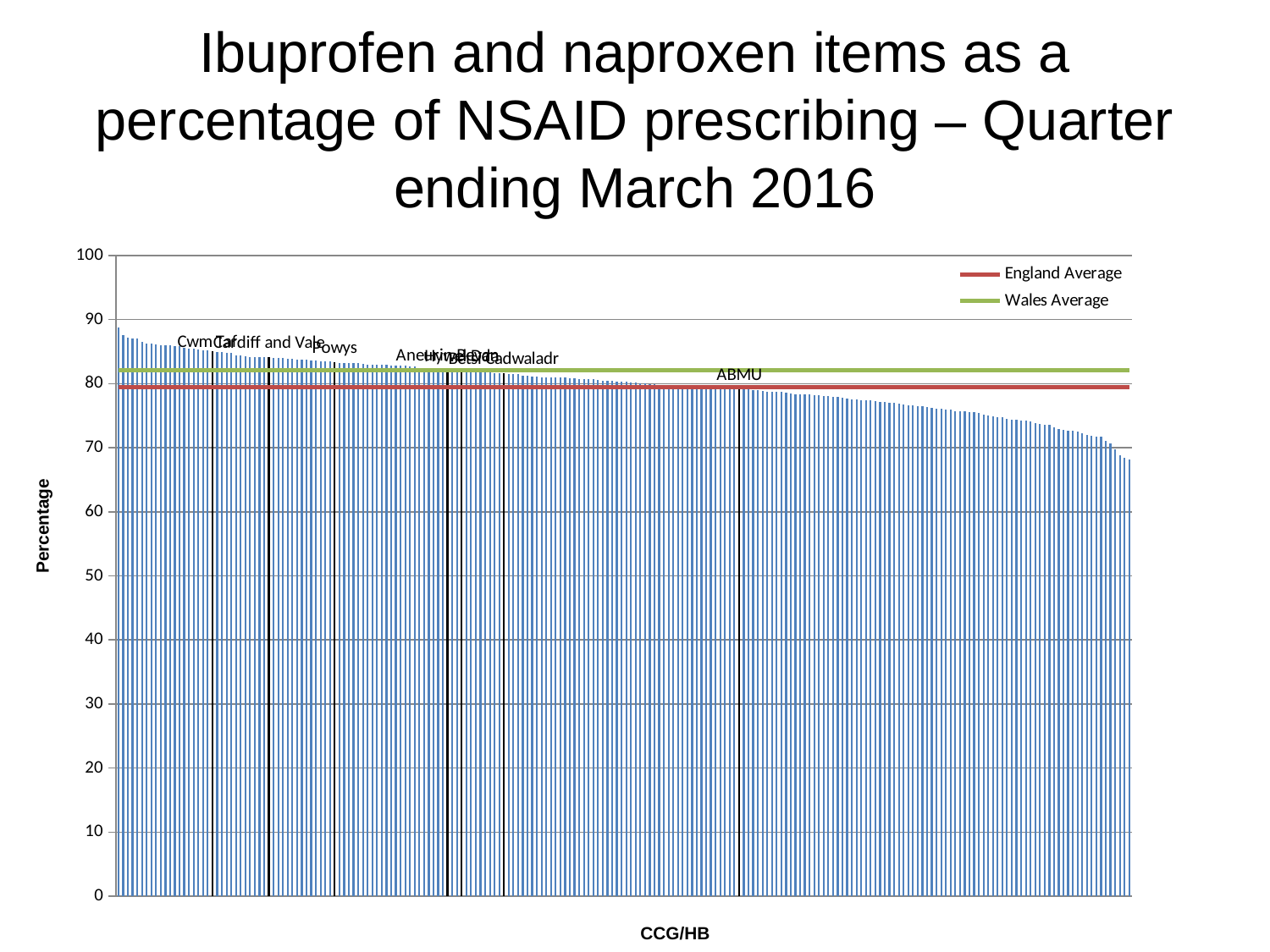
Which is higher, the Wales Average line or the England Average line? Wales Average Which two series are named in the legend? England Average and Wales Average Is the value for Cwm Taf greater or less than 80? greater How many series does the legend list? 2 Is the value for Powys greater or less than 80? greater Is the value of the tallest bar greater or less than 90? less Which has the larger value, Cwm Taf or ABMU? Cwm Taf What kind of chart is shown on the slide? bar chart Do the bar values rise or fall from left to right along the x axis? fall What is the label on the y axis? Percentage